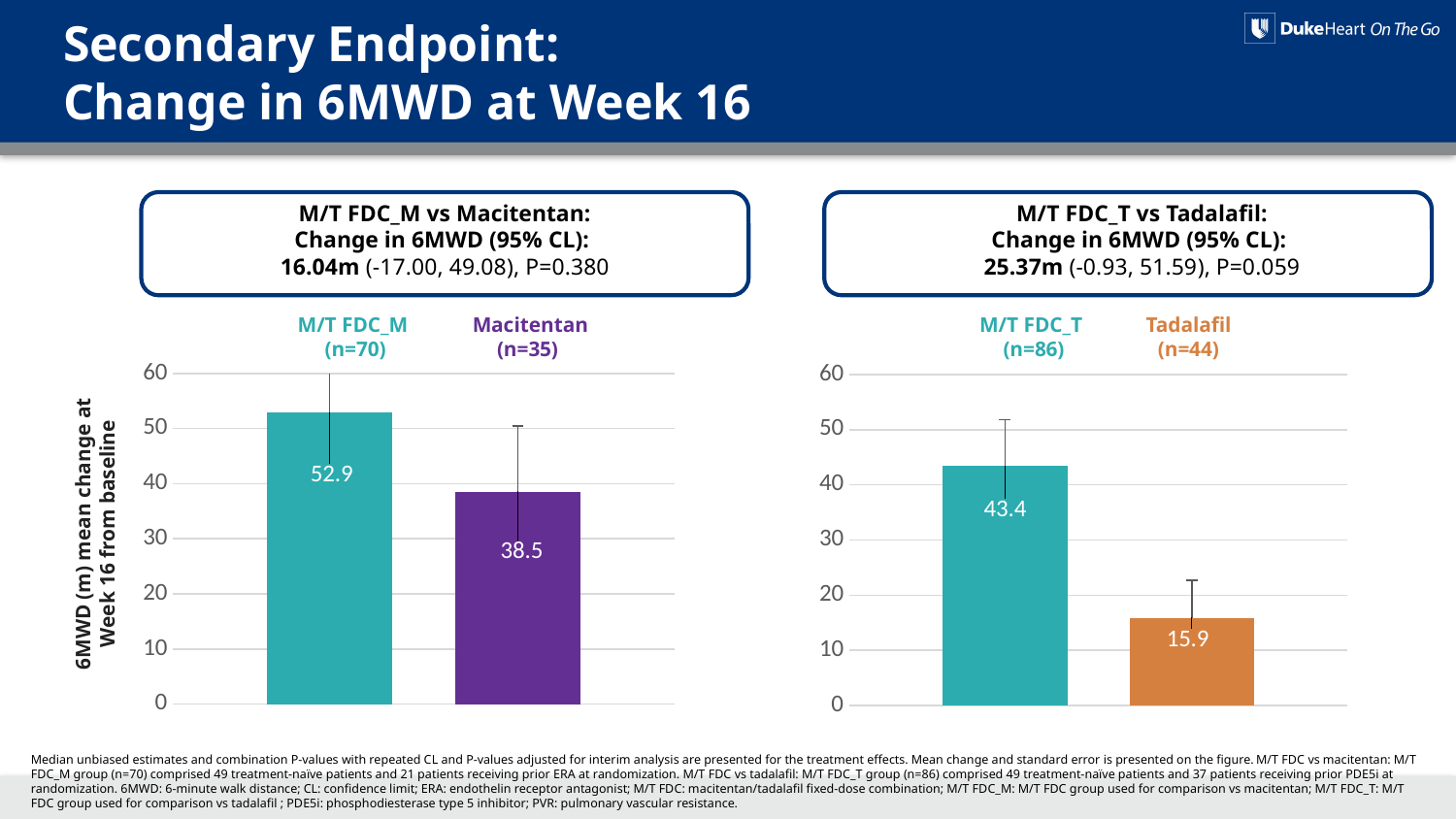
In the left chart (M/T FDC_M vs Macitentan), what is the mean change in 6MWD for the M/T FDC_M group? 52.9 In the right chart (M/T FDC_T vs Tadalafil), which group has the lower mean change in 6MWD? Tadalafil In the left chart (M/T FDC_M vs Macitentan), what is the difference between the M/T FDC_M and Macitentan bar values? 14.4 In the right chart (M/T FDC_T vs Tadalafil), what is the difference between the M/T FDC_T and Tadalafil bar values? 27.5 What is the y-axis label of the left chart (M/T FDC_M vs Macitentan)? 6MWD (m) mean change at Week 16 from baseline In the left chart (M/T FDC_M vs Macitentan), which group has the higher mean change in 6MWD? M/T FDC_M In the right chart (M/T FDC_T vs Tadalafil), is the value for Tadalafil greater or less than 20? less In the right chart (M/T FDC_T vs Tadalafil), what is the mean change in 6MWD for the M/T FDC_T group? 43.4 In the right chart (M/T FDC_T vs Tadalafil), what is the mean change in 6MWD for the Tadalafil group? 15.9 In the left chart (M/T FDC_M vs Macitentan), what is the mean change in 6MWD for the Macitentan group? 38.5 What type of chart is used on this slide to show the change in 6MWD? Bar chart How many bars are plotted in the left chart (M/T FDC_M vs Macitentan)? 2